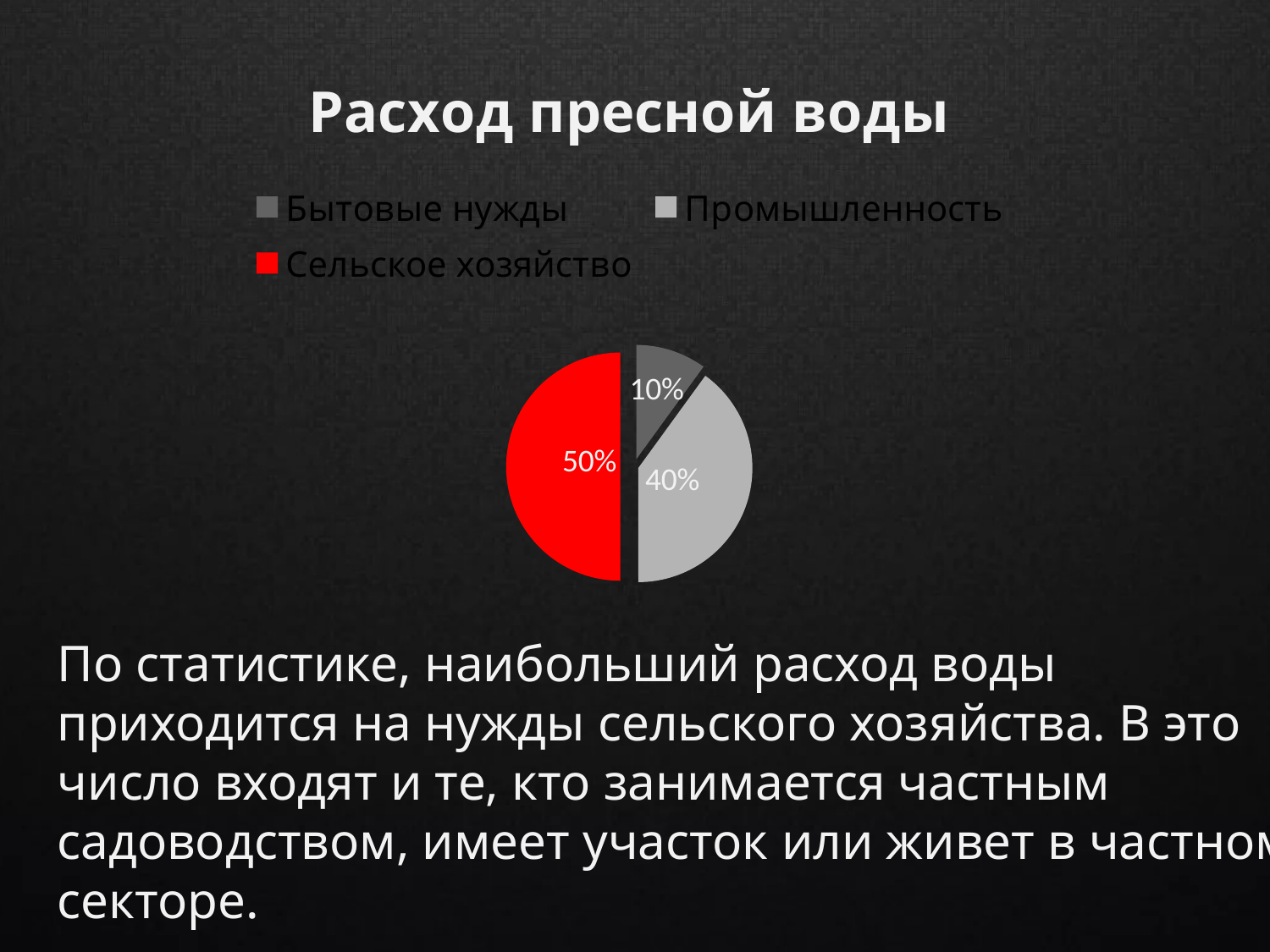
Which category has the smallest slice of the pie? Бытовые нужды What is the difference between the shares of Сельское хозяйство and Промышленность? 10% Which is larger, the share of Промышленность or the share of Бытовые нужды? Промышленность What colour is the slice for Сельское хозяйство? red How many categories does the pie chart show? 3 What is the difference between the shares of Промышленность and Бытовые нужды? 30% What share of the pie does Промышленность take? 40% What share of the pie does Бытовые нужды take? 10% What is the title of the chart? Расход пресной воды Which category has the largest slice of the pie? Сельское хозяйство What type of chart is shown on the slide? pie chart What share of the pie does Сельское хозяйство take? 50%